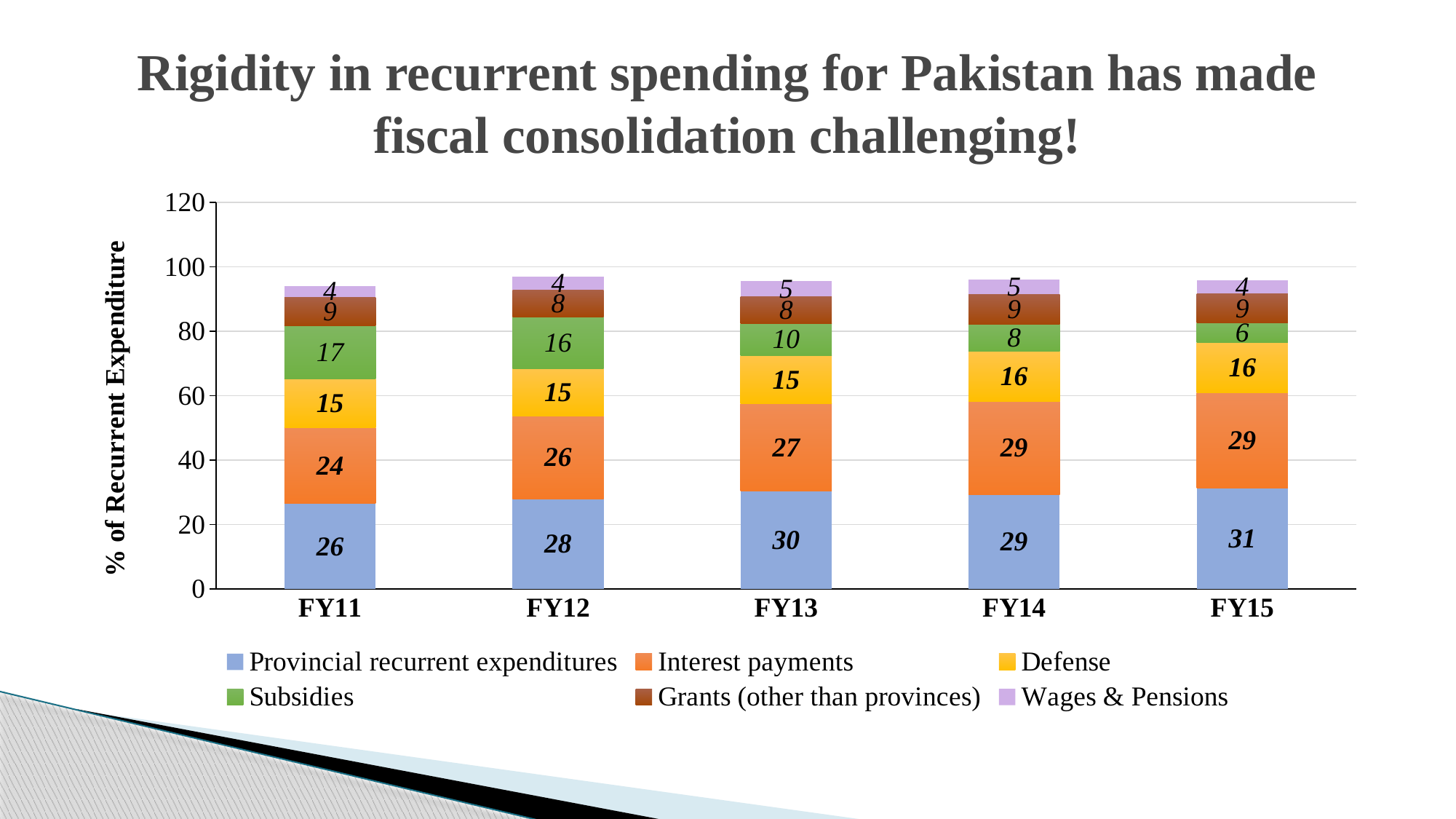
What is the title of the y axis? % of Recurrent Expenditure In which fiscal year is the Subsidies value lowest? FY15 In which fiscal year is the Subsidies value highest? FY11 In FY14, which is larger: Interest payments or Defense? Interest payments How many series does the legend list? 6 How many fiscal years are shown on the x axis? 5 Do the Provincial recurrent expenditures values rise or fall from FY11 to FY15? Rise What kind of chart is shown on the slide? Stacked bar chart What is the value for Interest payments in FY13? 27 What is the value for Provincial recurrent expenditures in FY15? 31 By how much did Provincial recurrent expenditures increase from FY11 to FY15? 5 What is the value for Subsidies in FY11? 17